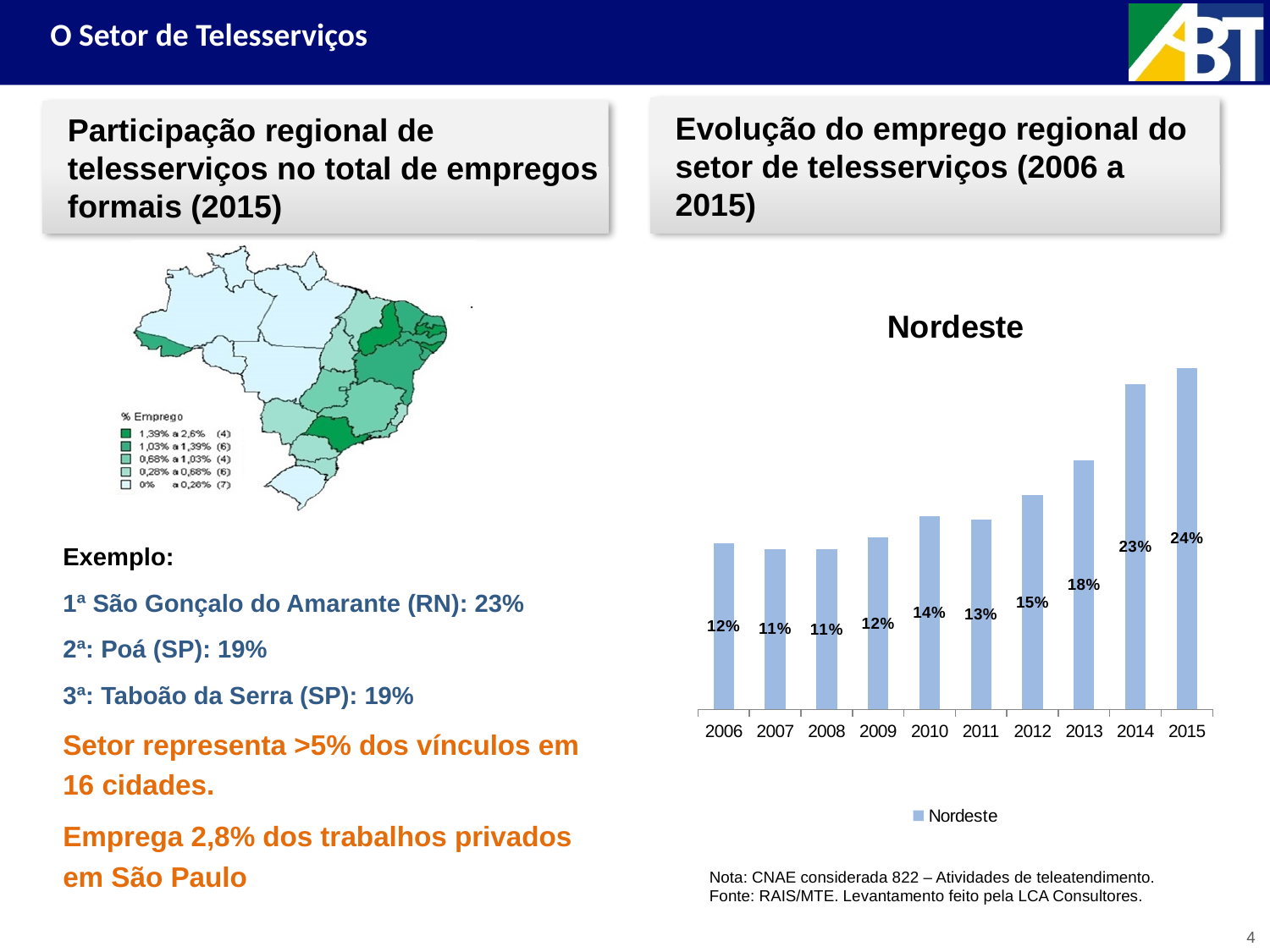
In the Nordeste chart, what is the value for 2006? 12% In the Nordeste chart, which is larger, the value for 2010 or the value for 2011? 2010 How many years are shown on the x axis of the Nordeste chart? 10 In the Nordeste chart, do the values generally rise or fall from 2006 to 2015? Rise What kind of chart is the Nordeste chart? Bar chart In the Nordeste chart, what is the value for 2015? 24% In the Nordeste chart, what is the value for 2010? 14% In the Nordeste chart, what is the difference between the values for 2015 and 2006? 12 percentage points In the Nordeste chart, which year has the highest value? 2015 In the Nordeste chart, what is the value for 2013? 18% In the Nordeste chart, what is the difference between the values for 2014 and 2013? 5 percentage points How many series does the legend of the Nordeste chart list? 1